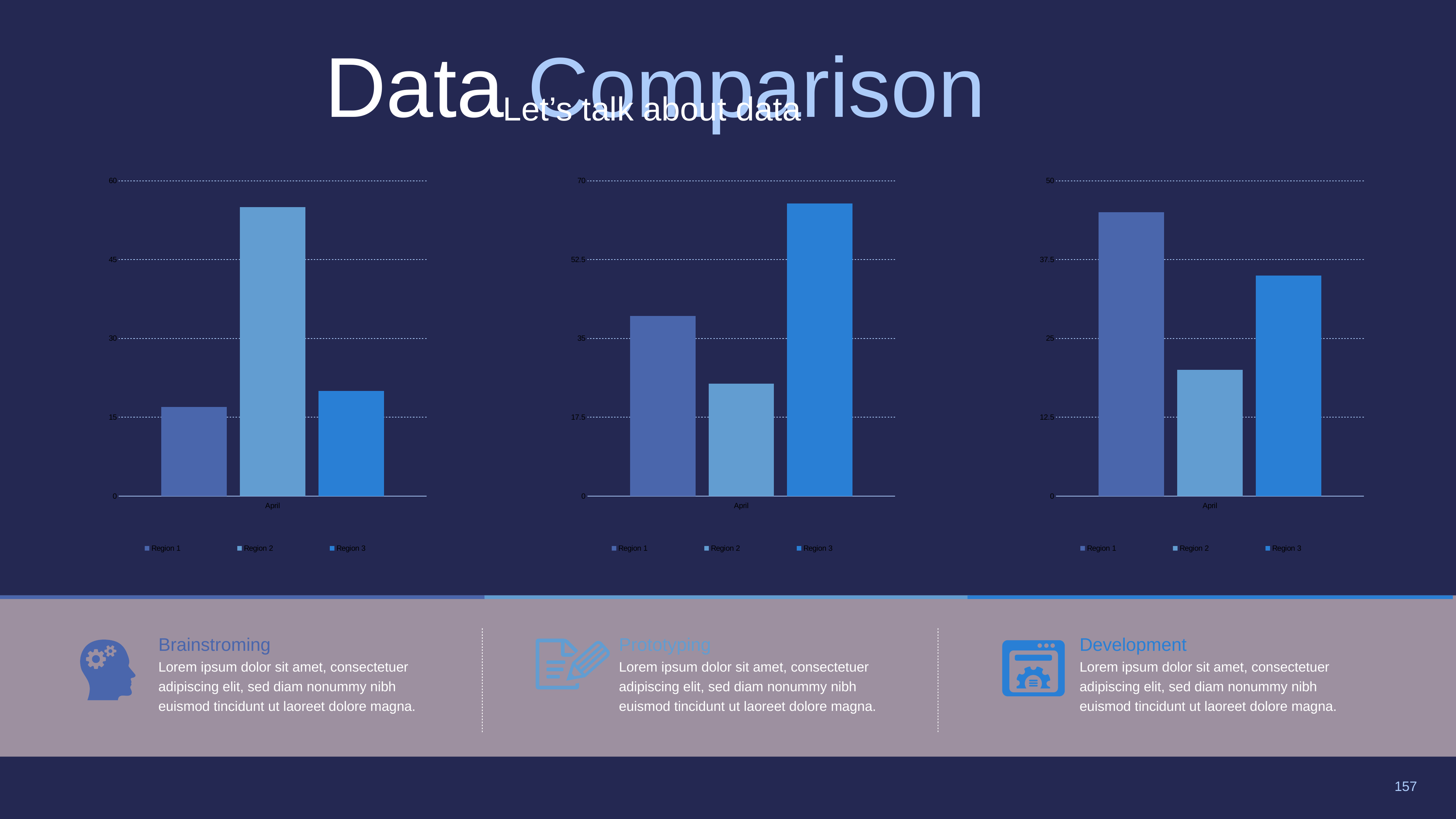
In the middle chart, which region has the lowest bar for April? Region 2 In the right chart, which region has the lowest bar for April? Region 2 In the left chart, what kind of chart is shown? bar chart In the left chart, which region has the highest bar for April? Region 2 In the right chart, is the value for Region 2 greater or less than 25? less In the middle chart, which is larger for April, Region 1 or Region 2? Region 1 In the middle chart, is the value for Region 3 greater or less than 52.5? greater In the middle chart, how many categories are shown on the x axis? 1 In the right chart, which region has the highest bar for April? Region 1 In the left chart, is the value for Region 2 greater or less than 45? greater In the right chart, what category label is shown on the x axis? April In the left chart, how many series does the legend list? 3